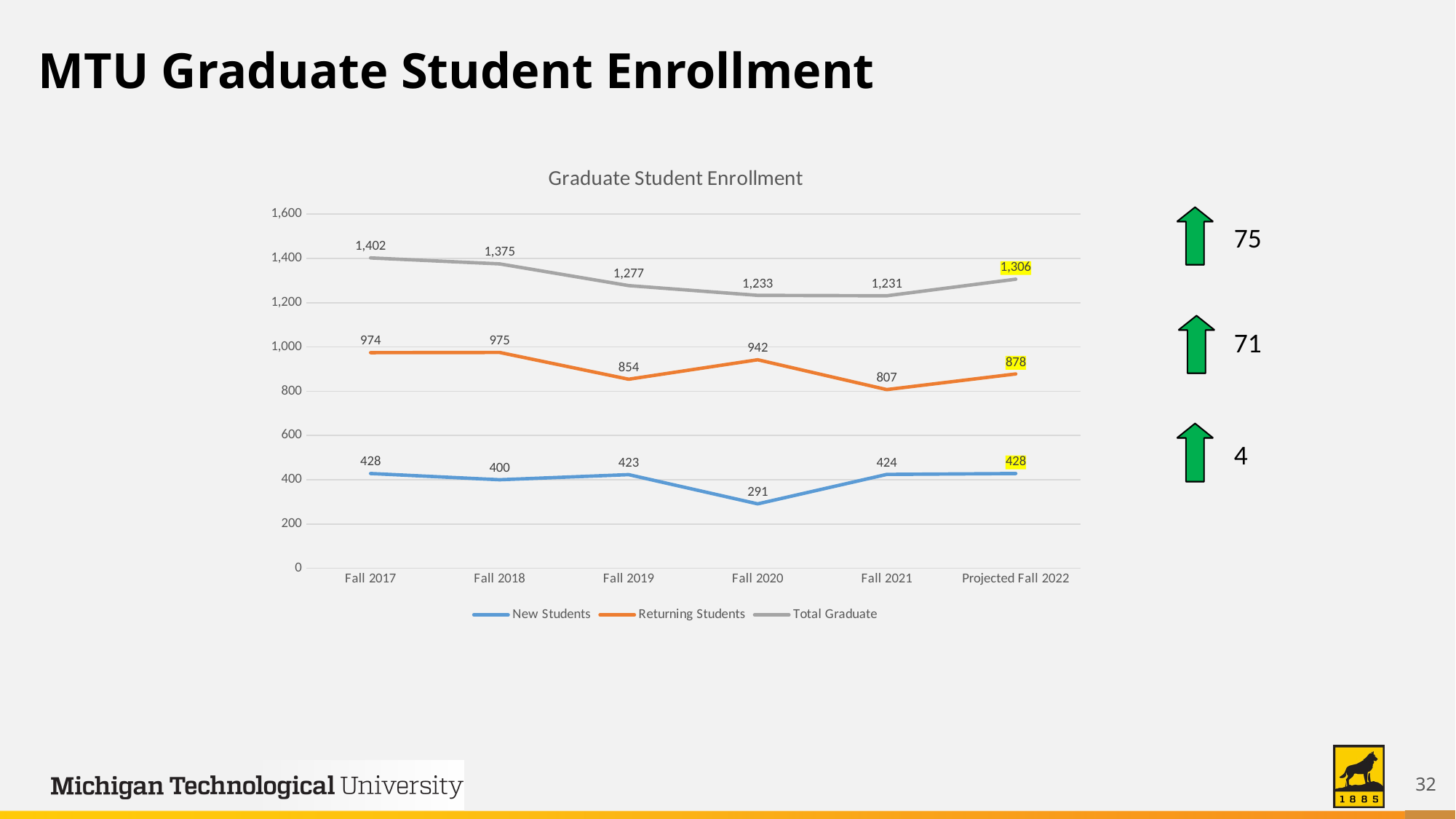
What is the Total Graduate enrollment for Fall 2017? 1,402 In which period is the Total Graduate value highest? Fall 2017 What is the New Students value for Projected Fall 2022? 428 What is the difference between the Total Graduate values for Fall 2021 and Projected Fall 2022? 75 In which period is the New Students value lowest? Fall 2020 How many time periods are shown on the x axis? 6 Which is larger, the Returning Students value for Fall 2019 or for Fall 2021? Fall 2019 What is the Returning Students value for Fall 2020? 942 What kind of chart is shown on the slide? Line chart Does the Total Graduate series rise or fall from Fall 2017 to Fall 2021? Fall What is the difference between the Returning Students values for Fall 2018 and Fall 2019? 121 How many series does the legend list? 3